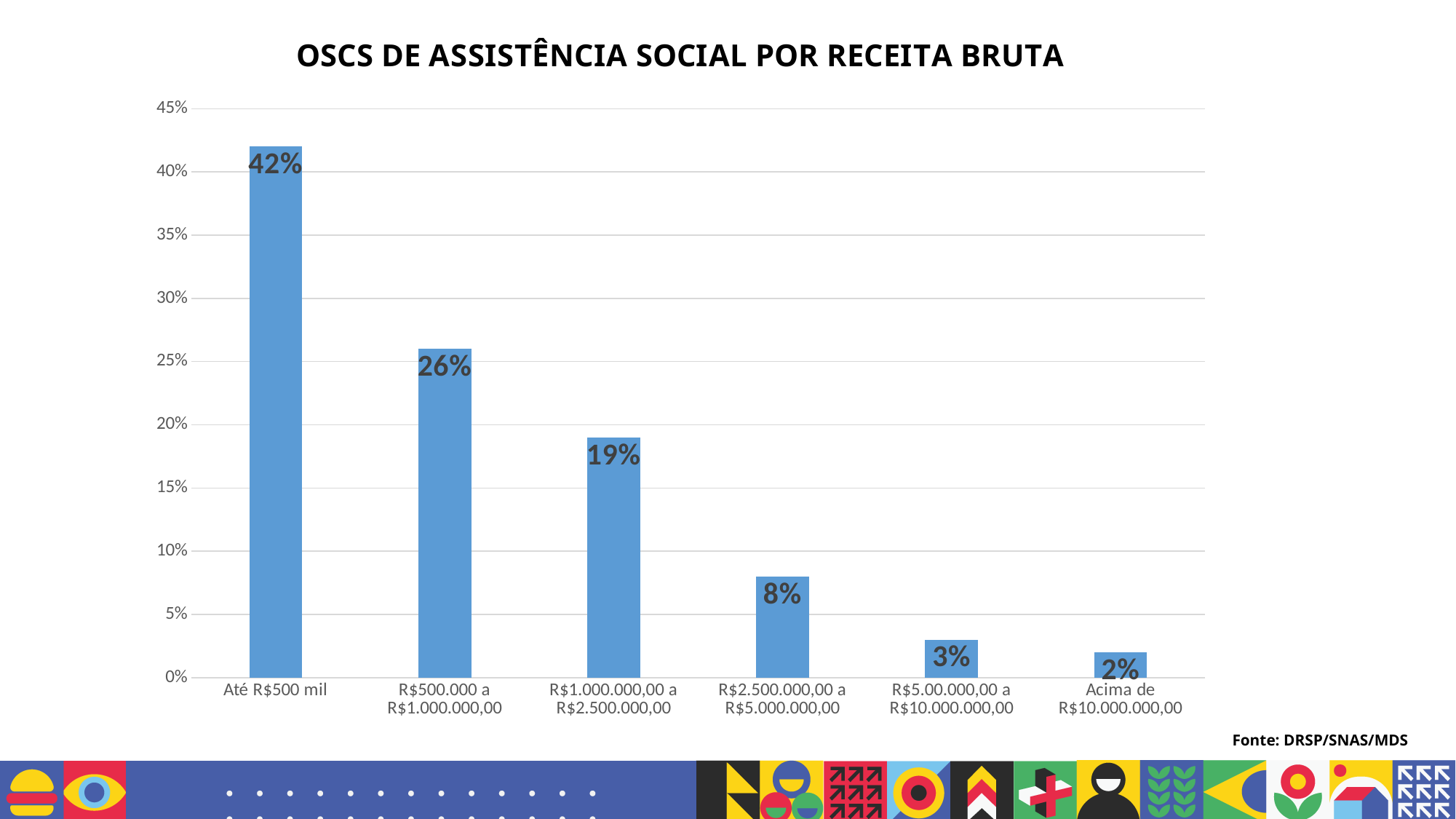
What is the title of the chart? OSCS DE ASSISTÊNCIA SOCIAL POR RECEITA BRUTA Do the values rise or fall from left to right along the x axis? Fall What is the value for the 'Até R$500 mil' category? 42% Which category has the lowest value? Acima de R$10.000.000,00 What is the value for the 'R$1.000.000,00 a R$2.500.000,00' category? 19% What is the value for the 'Acima de R$10.000.000,00' category? 2% What is the difference between the values for 'Até R$500 mil' and 'R$500.000 a R$1.000.000,00'? 16% What kind of chart is shown on the slide? Bar chart Which is larger, the value for 'R$2.500.000,00 a R$5.000.000,00' or the value for 'R$5.00.000,00 a R$10.000.000,00'? R$2.500.000,00 a R$5.000.000,00 Which category has the highest value? Até R$500 mil How many categories are shown on the x axis? 6 What is the value for the 'R$500.000 a R$1.000.000,00' category? 26%